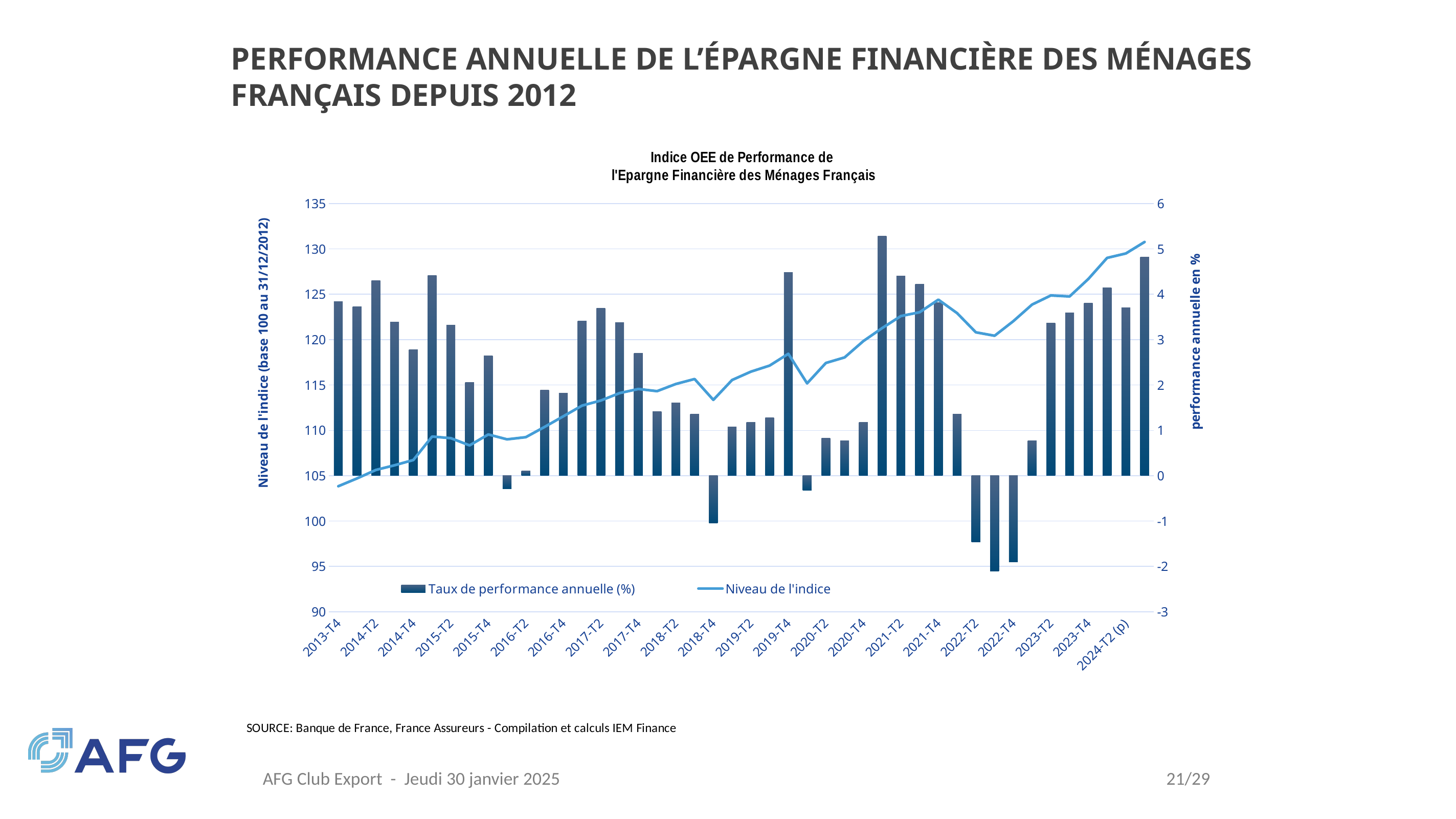
Is the Niveau de l'indice line at 2024-T2 (p) greater or less than 125? greater Is the Taux de performance annuelle bar for 2022-T4 greater or less than -1? less What is the title of the chart? Indice OEE de Performance de l'Epargne Financière des Ménages Français Is the Taux de performance annuelle bar for 2021-T2 greater or less than 5? less What are the two series named in the legend? Taux de performance annuelle (%) and Niveau de l'indice Which has the larger Taux de performance annuelle bar, 2021-T2 or 2022-T4? 2021-T2 Does the Niveau de l'indice line rise or fall overall from 2013-T4 to 2024-T2 (p)? rise How many series does the chart legend list? 2 What kind of chart is shown on the slide? A combined bar and line chart